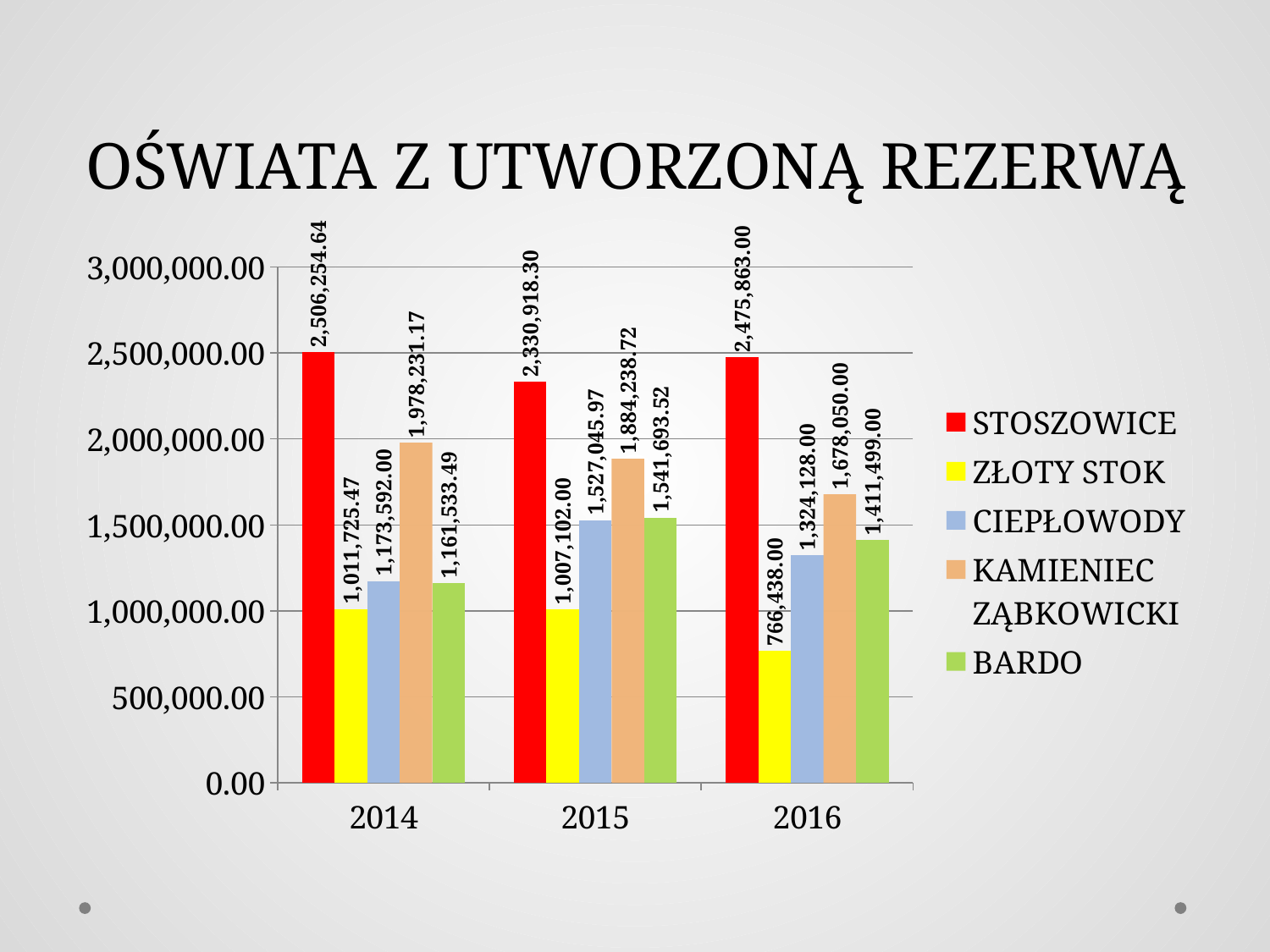
What kind of chart is shown on the slide? bar chart Do the values for ZŁOTY STOK rise or fall from 2014 to 2016? fall What is the value for KAMIENIEC ZĄBKOWICKI in 2015? 1,884,238.72 What is the value for BARDO in 2014? 1,161,533.49 Which series has the highest value in 2016? STOSZOWICE What is the value for STOSZOWICE in 2014? 2,506,254.64 How many series does the legend list? 5 Which is larger in 2014: CIEPŁOWODY or KAMIENIEC ZĄBKOWICKI? KAMIENIEC ZĄBKOWICKI What is the difference between the STOSZOWICE and ZŁOTY STOK values in 2016? 1,709,425.00 Is the value for STOSZOWICE in 2015 greater or less than 2,500,000.00? less Which series has the lowest value in 2015? ZŁOTY STOK What is the value for ZŁOTY STOK in 2016? 766,438.00